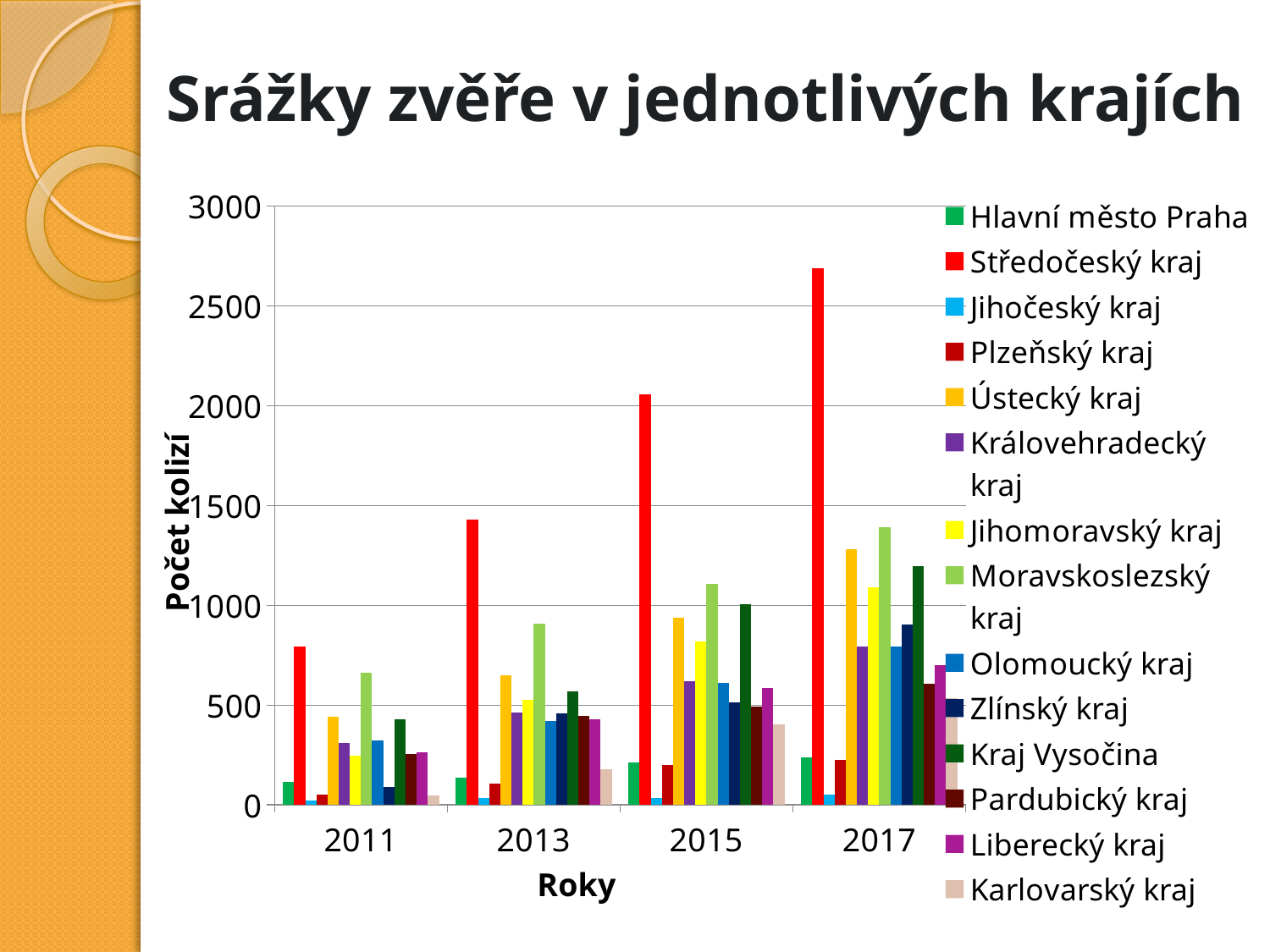
Which region has the lowest value in 2017? Jihočeský kraj What is the title of the y axis? Počet kolizí Do the values for Středočeský kraj rise or fall from 2011 to 2017? rise Is the value for Středočeský kraj in 2017 greater or less than 2500? greater Is the value for Středočeský kraj in 2013 greater or less than 1500? less How many series does the legend list? 14 Is the value for Hlavní město Praha in 2015 greater or less than 500? less What kind of chart is shown on the slide? bar chart Which region has the highest value in 2017? Středočeský kraj Which is larger: the value for Středočeský kraj in 2015 or in 2017? 2017 How many years are shown on the x axis? 4